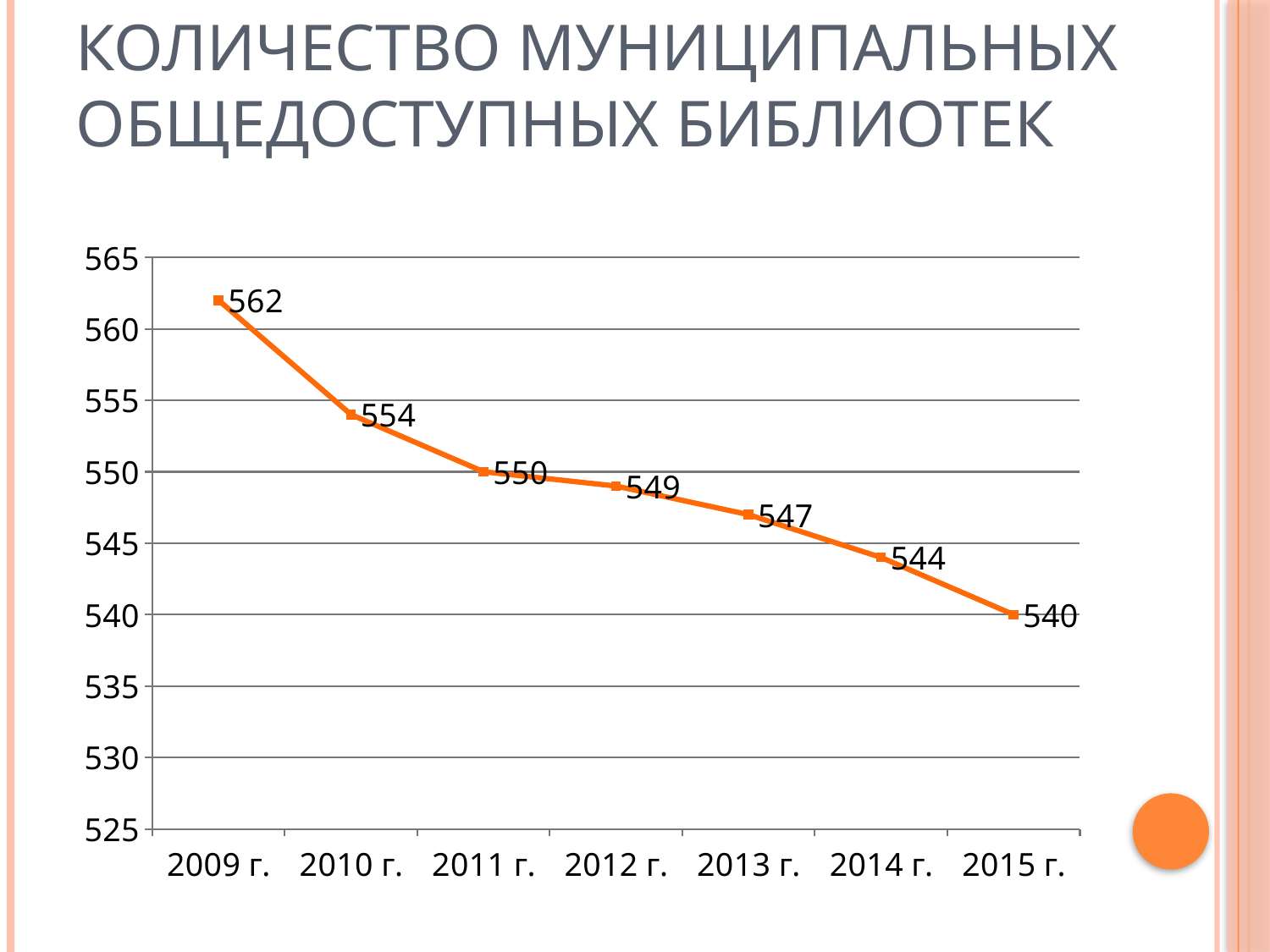
Do the values rise or fall from 2009 г. to 2015 г.? fall Which year has the highest value? 2009 г. What is the value for 2012 г.? 549 What is the difference between the values for 2009 г. and 2015 г.? 22 What kind of chart is shown on the slide? line chart How many years are plotted on the chart? 7 Is the value for 2011 г. greater or less than 545? greater Which year has the lowest value? 2015 г. What is the difference between the values for 2010 г. and 2011 г.? 4 Which is larger, the value for 2013 г. or the value for 2014 г.? 2013 г. What is the value for 2009 г.? 562 What is the value for 2015 г.? 540